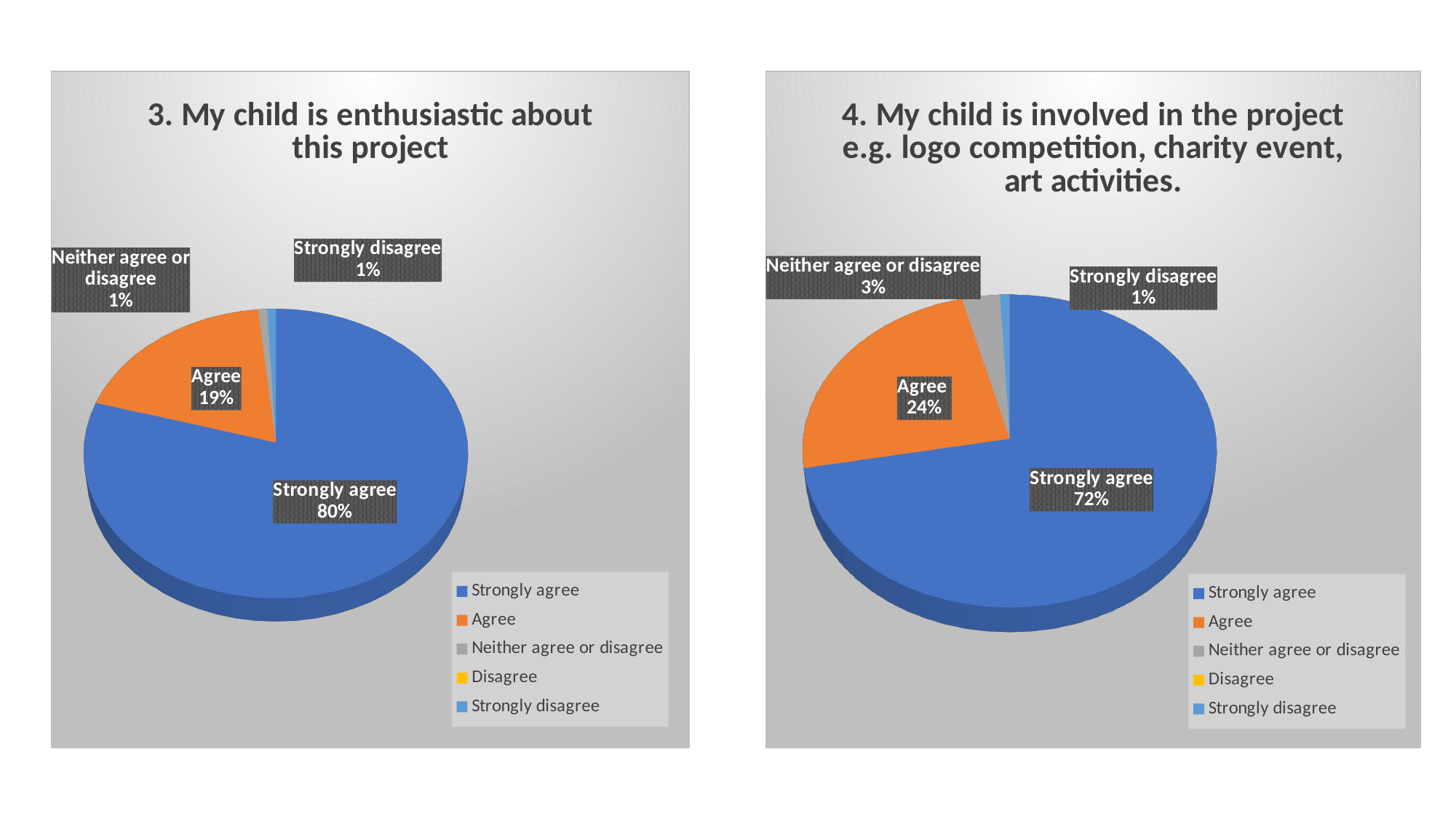
In the chart titled '4. My child is involved in the project e.g. logo competition, charity event, art activities.', what percentage is shown for Strongly agree? 72% What type of chart is the left chart? Pie chart In the left chart, what colour is the Agree slice? Orange In the right chart, which category has the largest slice? Strongly agree In the left chart, which category has the largest slice? Strongly agree In the chart titled '3. My child is enthusiastic about this project', what percentage is shown for Agree? 19% In the left chart, what is the difference between the Strongly agree and Agree percentages? 61% In the chart titled '3. My child is enthusiastic about this project', what percentage is shown for Strongly agree? 80% In the chart titled '4. My child is involved in the project e.g. logo competition, charity event, art activities.', what percentage is shown for Neither agree or disagree? 3% In the right chart, what is the difference between the Strongly agree and Agree percentages? 48% How many entries does the legend of the right chart list? 5 Which is larger in the right chart: the Agree slice or the Neither agree or disagree slice? Agree